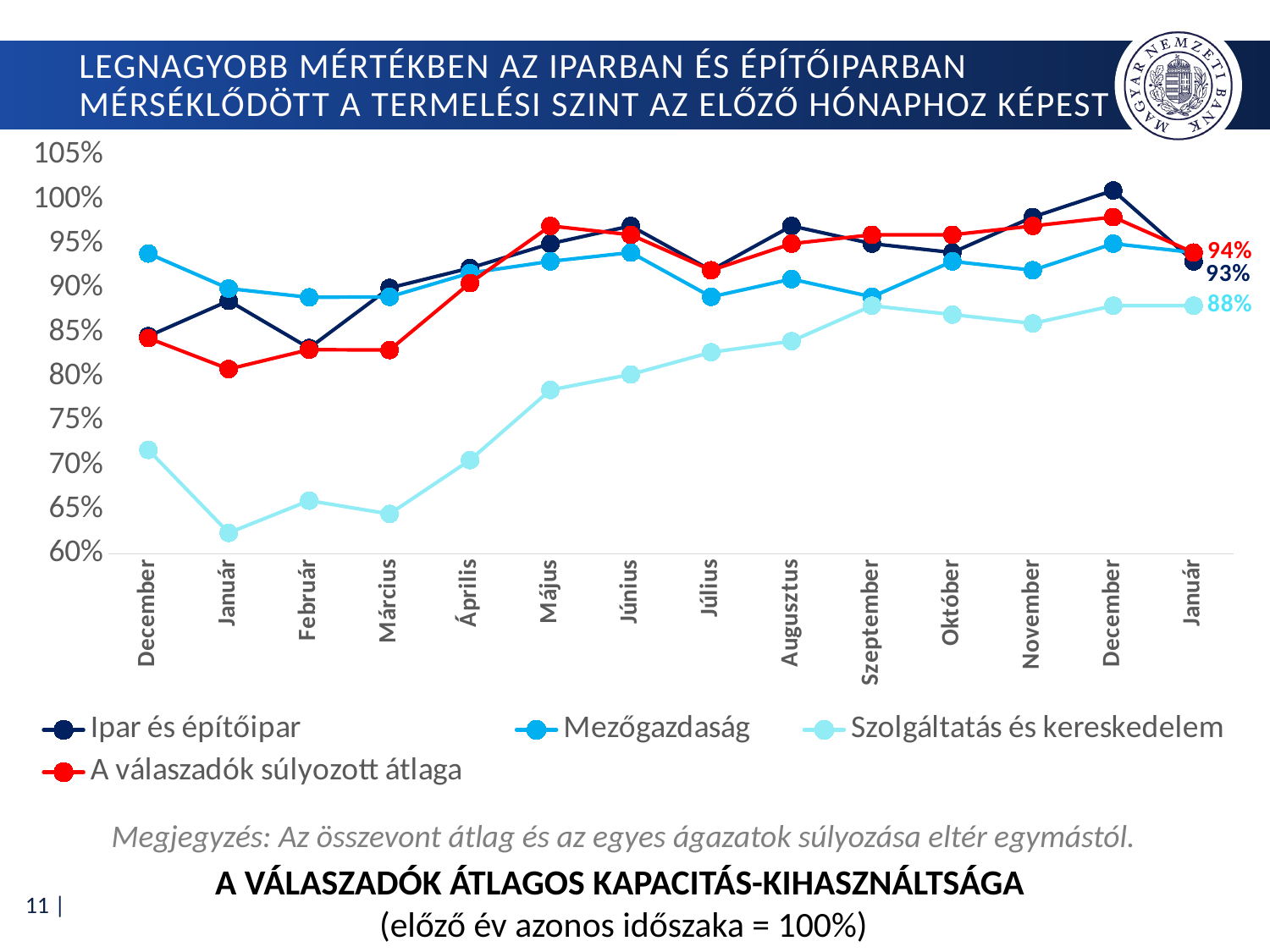
Does 'Szolgáltatás és kereskedelem' generally rise or fall from the first Január to the final Január? rise What kind of chart is shown on the slide? line chart Is the value for 'Ipar és építőipar' in the second December greater or less than 100%? greater Is the value for 'Szolgáltatás és kereskedelem' in the first Január greater or less than 65%? less What is the value of 'Ipar és építőipar' at the final Január? 93% How many series does the legend list? 4 What is the value of 'Szolgáltatás és kereskedelem' at the final Január? 88% What is the value of 'A válaszadók súlyozott átlaga' at the final Január? 94% At the final Január, how many percentage points higher is 'A válaszadók súlyozott átlaga' than 'Szolgáltatás és kereskedelem'? 6 percentage points In the first December, which is higher: 'Mezőgazdaság' or 'Ipar és építőipar'? Mezőgazdaság How many months are shown along the x axis? 14 In which month does 'Szolgáltatás és kereskedelem' reach its lowest value? Január (the first one)